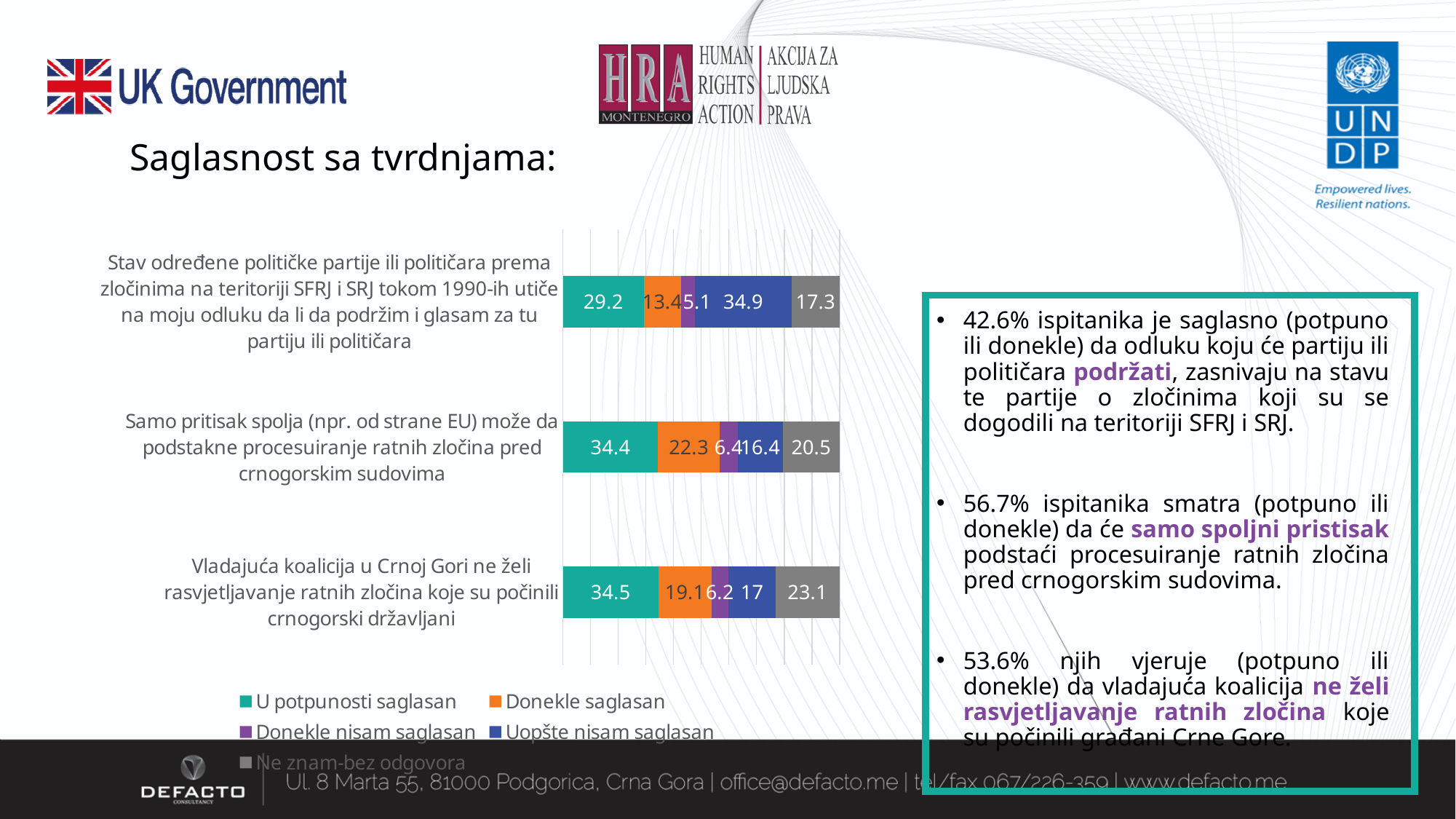
How many statements are shown in the chart? 3 Which statement has the lowest "U potpunosti saglasan" value? Stav određene političke partije ili političara prema zločinima na teritoriji SFRJ i SRJ tokom 1990-ih utiče na moju odluku da li da podržim i glasam za tu partiju ili političara What is the difference between the "Uopšte nisam saglasan" values for the first statement (34.9) and the second statement (16.4)? 18.5 What percentage of respondents answered "U potpunosti saglasan" to the statement "Samo pritisak spolja (npr. od strane EU) može da podstakne procesuiranje ratnih zločina pred crnogorskim sudovima"? 34.4 What is the "Ne znam-bez odgovora" value for the statement "Vladajuća koalicija u Crnoj Gori ne želi rasvjetljavanje ratnih zločina koje su počinili crnogorski državljani"? 23.1 How many series does the legend list? 5 Is the "Donekle nisam saglasan" value larger for the second statement (about external pressure) or the third statement (about the ruling coalition)? The second statement (6.4) What type of chart is shown on the slide? Stacked bar chart Which colour represents "U potpunosti saglasan" in the chart? Teal (green) Which statement has the highest "Donekle saglasan" value? Samo pritisak spolja (npr. od strane EU) može da podstakne procesuiranje ratnih zločina pred crnogorskim sudovima What is the "Uopšte nisam saglasan" value for the statement about a political party's stance on crimes in the former SFRJ and SRJ influencing the respondent's vote? 34.9 What is the total of the segments in the bar for the statement "Samo pritisak spolja (npr. od strane EU) može da podstakne procesuiranje ratnih zločina pred crnogorskim sudovima"? 100